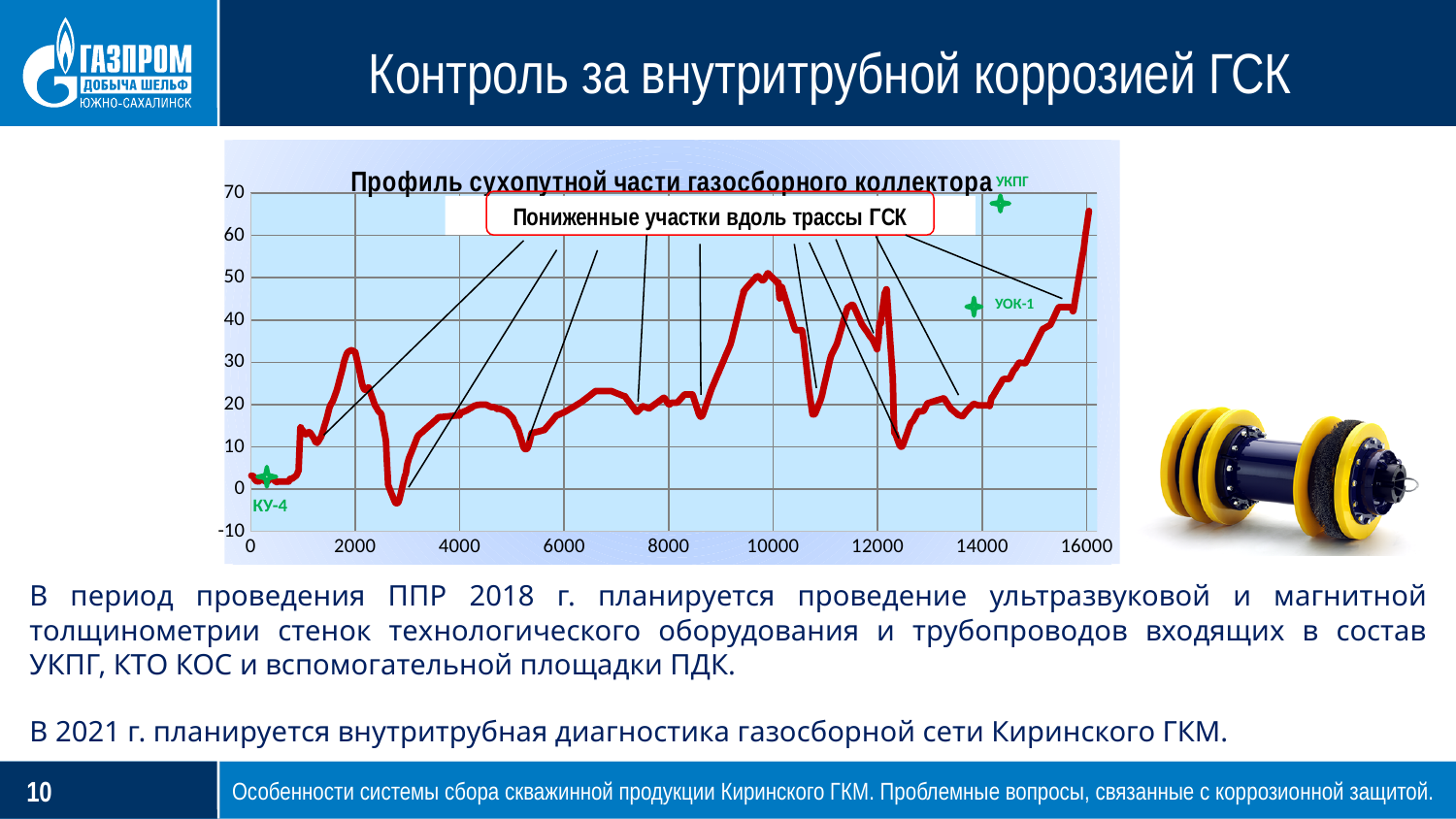
Is the value of the profile at x = 10000 greater or less than 40? greater What is the highest value shown on the vertical axis of the chart? 70 Comparing the start (x = 0) and the end (x = 16000) of the chart, does the profile overall rise or fall? rise Near which x-axis value does the profile reach its highest point? 16000 What kind of chart is shown on the slide? line chart What is the title of the chart? Профиль сухопутной части газосборного коллектора Which is larger: the profile value at x = 10000 or at x = 6000? x = 10000 Is the value of the profile at x = 0 greater or less than 10? less Is the value of the profile at the right end of the chart (x = 16000) greater or less than 60? greater How many data series (lines) are plotted on the chart? 1